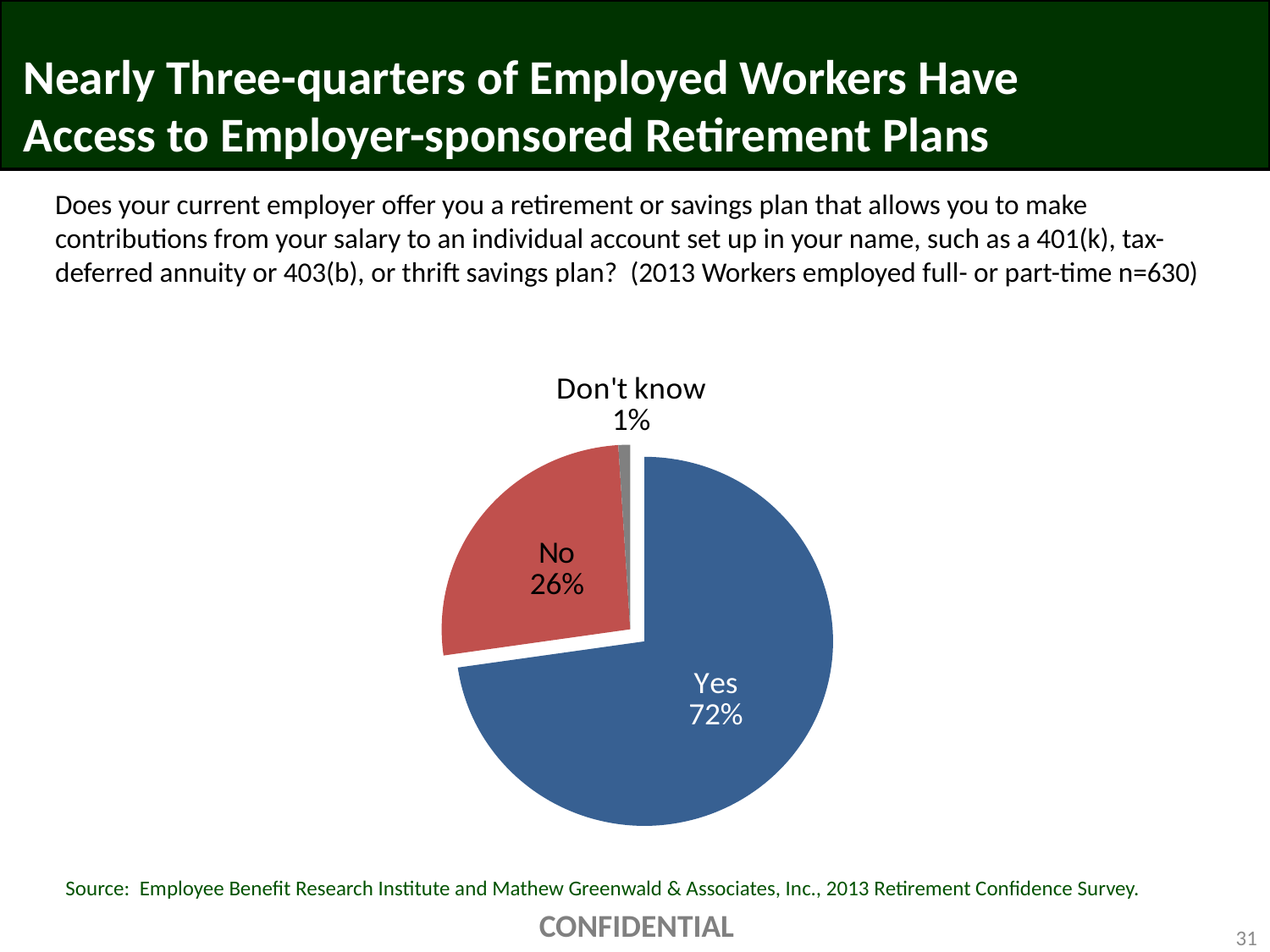
Which is larger, the "No" slice or the "Don't know" slice? No What is the difference in percentage points between the "Yes" and "No" slices? 46 What percentage of workers answered "No"? 26% What kind of chart is shown on the slide? Pie chart What colour is the "No" slice? Red What share of the pie does the "No" slice represent? 26% What percentage of workers answered "Don't know"? 1% How many slices does the pie chart have? 3 What percentage of workers answered "Yes"? 72% Which response has the smallest share of the pie? Don't know What colour is the "Yes" slice? Blue Which response has the largest share of the pie? Yes